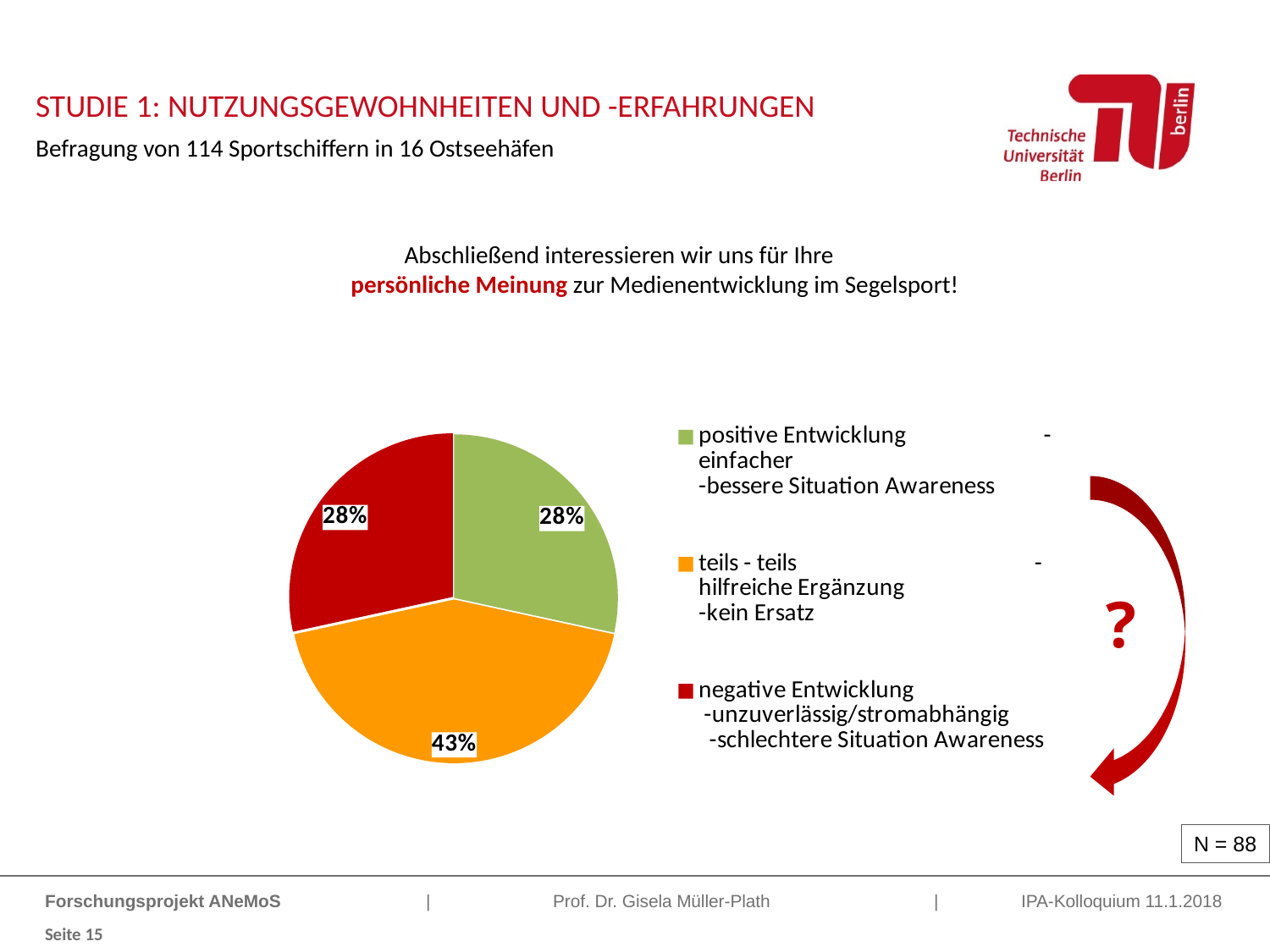
What share of the pie does "teils - teils" hold? 43% Which category has the largest slice of the pie? teils - teils What type of chart is shown on the slide? pie chart What share of the pie does "positive Entwicklung" hold? 28% How many entries does the legend list? 3 How many slices does the pie chart have? 3 Which is larger: the slice for "teils - teils" or the slice for "positive Entwicklung"? teils - teils What colour is the "teils - teils" slice in the pie chart? orange What is the difference in percentage points between the "teils - teils" slice and the "negative Entwicklung" slice? 15 percentage points Is the share for "teils - teils" greater or less than 40%? greater What sample size (N) is given for the pie chart? N = 88 What share of the pie does "negative Entwicklung" hold? 28%